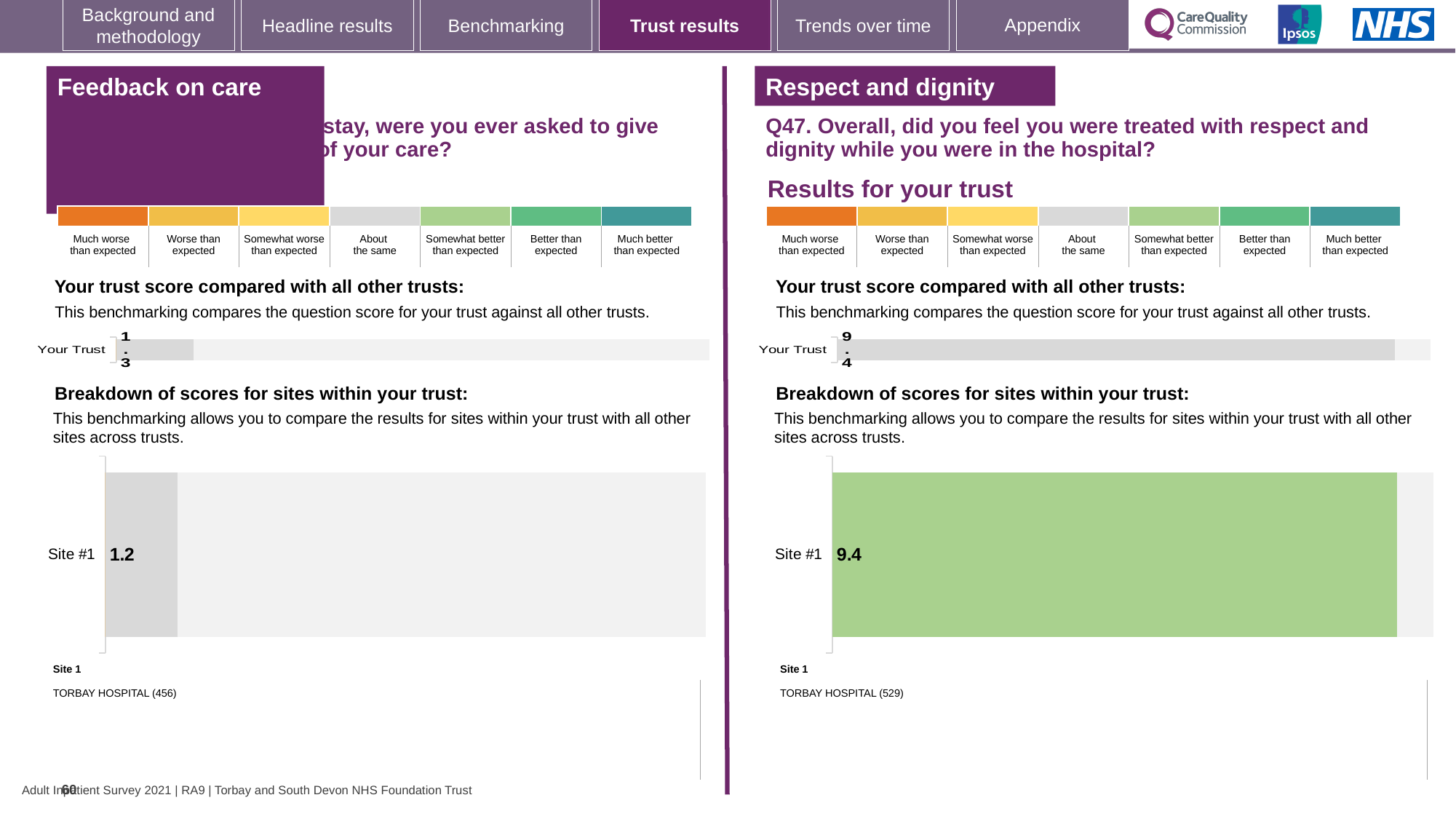
In the Respect and dignity section, which is larger: the Your Trust score or the Site #1 score? They are equal What type of chart is used to show the Site #1 score in the Respect and dignity section? Bar chart On the Respect and dignity section, what is the score shown for Site #1? 9.4 Which site name is listed as Site 1 in the Respect and dignity section? TORBAY HOSPITAL (529) How many sites are shown in the breakdown of scores in the Feedback on care section? 1 On the Feedback on care section, what is the score shown for Your Trust? 1.3 On the Respect and dignity section, what is the score shown for Your Trust? 9.4 On the Feedback on care section, what is the score shown for Site #1? 1.2 Which is larger: the Site #1 score in the Feedback on care section or the Site #1 score in the Respect and dignity section? Respect and dignity What colour is the Site #1 bar in the Respect and dignity section? Light green In the Feedback on care section, what is the difference between the Your Trust score and the Site #1 score? 0.1 What is the difference between the Site #1 score in the Respect and dignity section and the Site #1 score in the Feedback on care section? 8.2